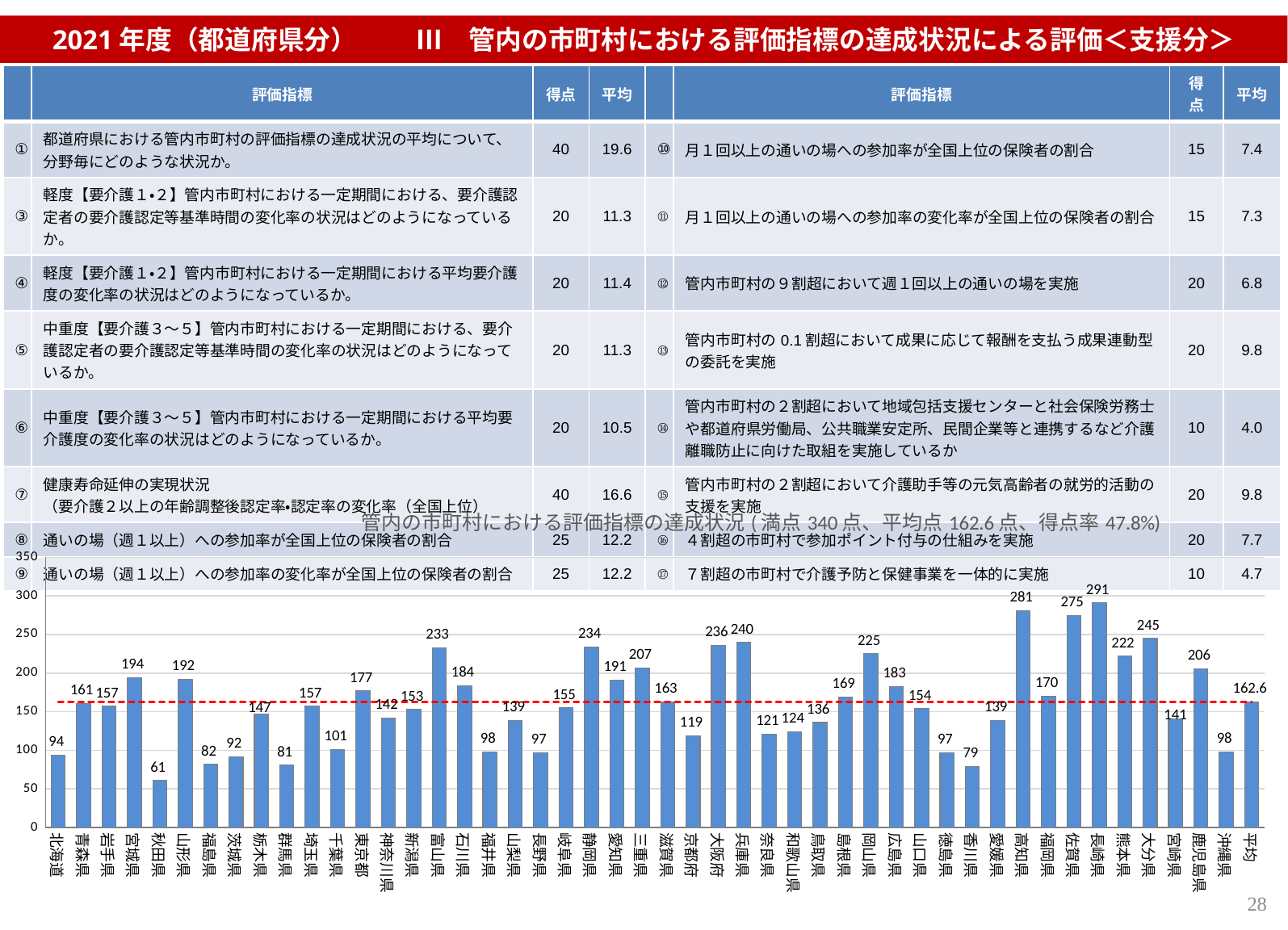
What is the value for 兵庫県 in the bar chart? 240 What is the 満点 (maximum score) stated in the chart title? 340点 What is the value for 平均 (the last bar) in the bar chart? 162.6 What is the value for 北海道 in the bar chart? 94 Which prefecture has the highest value in the bar chart? 長崎県 What is the 得点率 stated in the chart title? 47.8% What is the difference between the values for 高知県 and 香川県 in the bar chart? 202 Which prefecture has the lowest value in the bar chart? 秋田県 Is the value for 佐賀県 greater or less than 250? greater How many bars are plotted in the bar chart, including 平均? 48 Which has a larger value in the bar chart, 富山県 or 静岡県? 静岡県 What kind of chart is shown at the bottom of the slide? bar chart